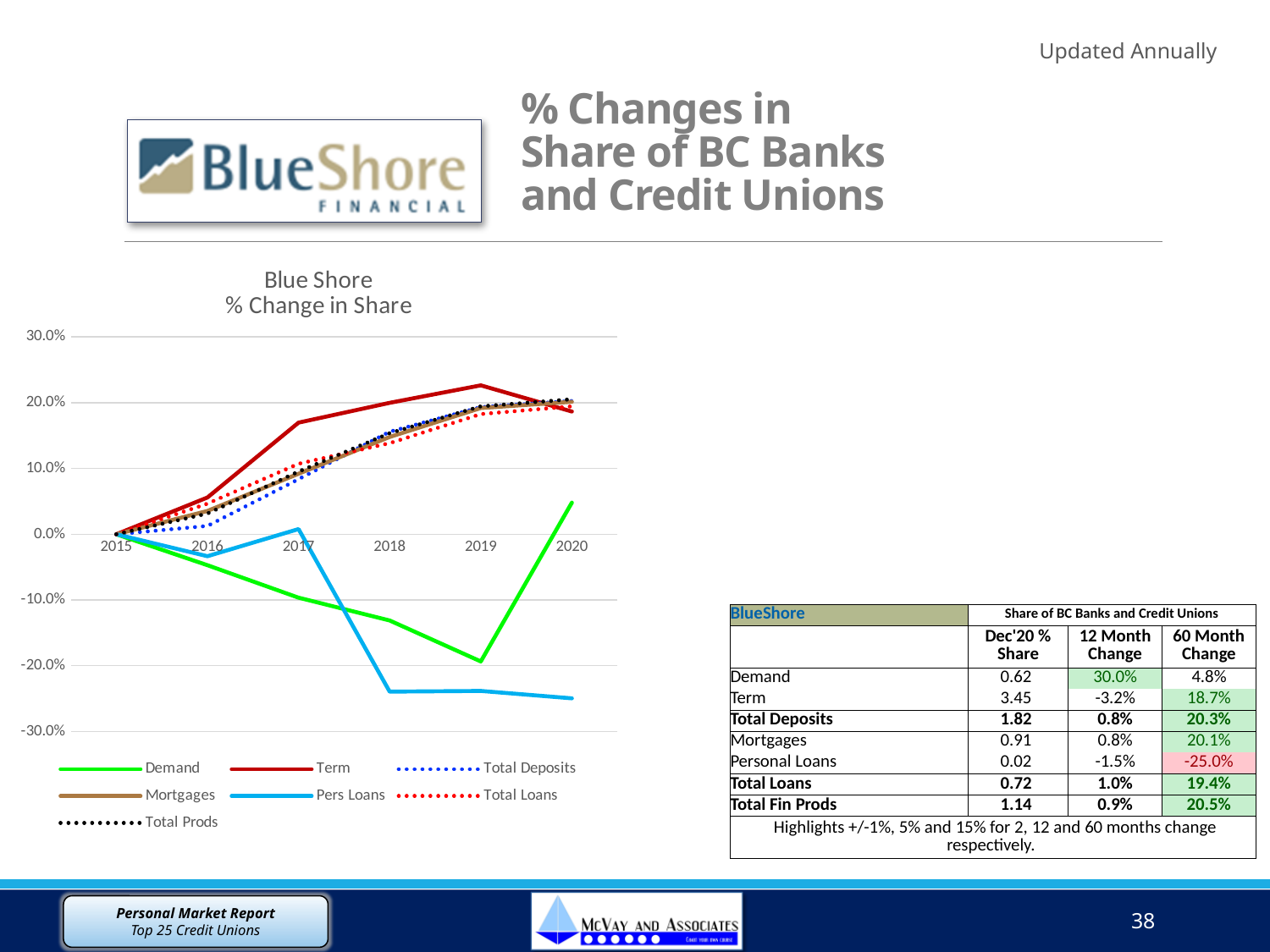
Is the value for Term in 2019 greater or less than 20.0%? greater In 2020, which is larger: the value for Demand or the value for Pers Loans? Demand Which series is drawn as the solid green line in the chart? Demand How many series does the chart legend list? 7 What kind of chart is shown on the slide? line chart Is the value for Pers Loans in 2018 greater or less than -20.0%? less Does the Term line rise or fall from 2015 to 2019? rise How many years are shown along the x axis of the chart? 6 Is the value for Demand in 2019 greater or less than -10.0%? less Which series has the lowest value in 2020? Pers Loans What is the title of the chart? Blue Shore % Change in Share Which series has the highest value in 2019? Term